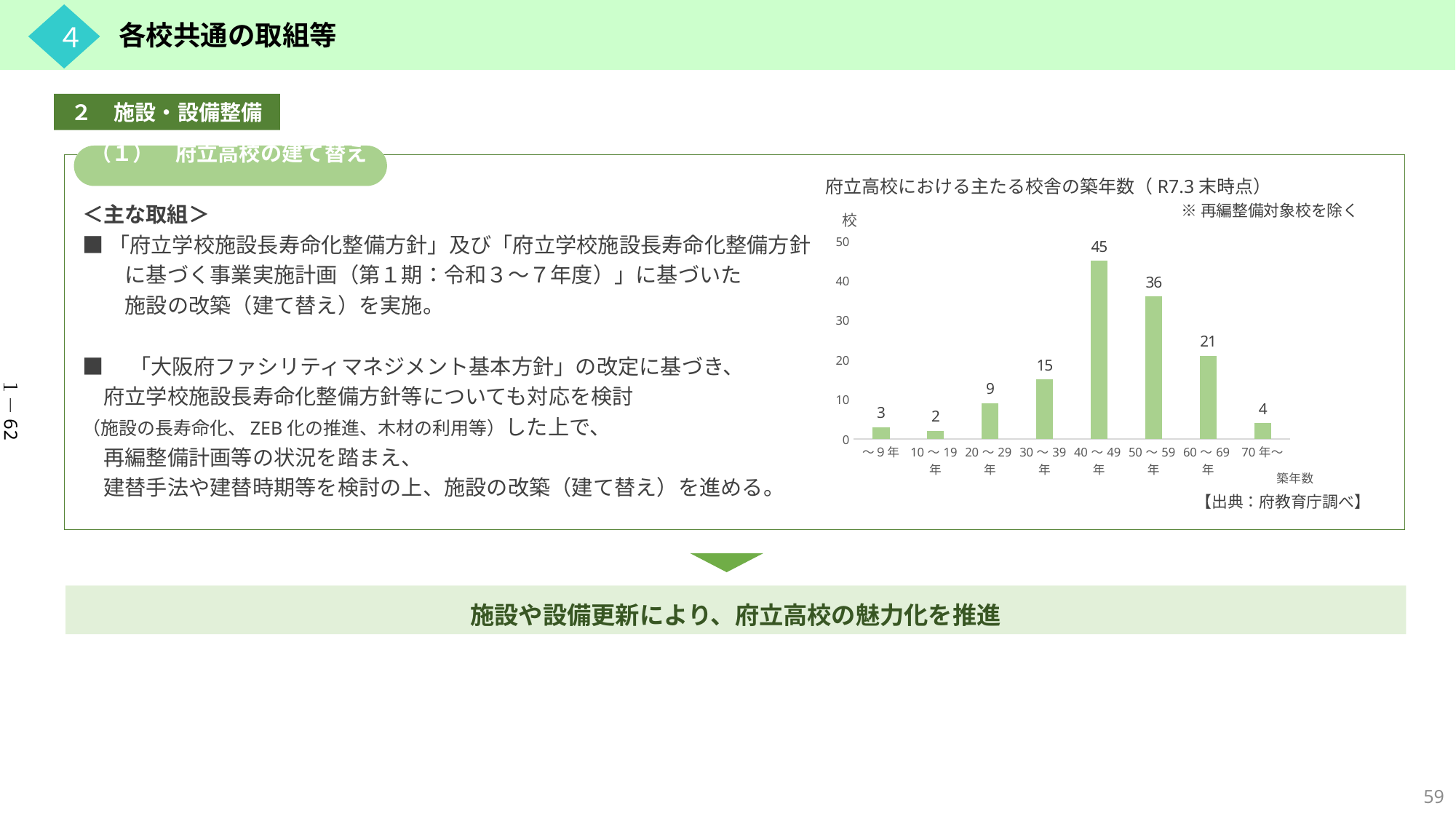
Is the value for 50～59年 greater or less than 30? greater Which category has the lowest value? 10～19年 What is the value for the 10～19年 category? 2 What is the title of the chart? 府立高校における主たる校舎の築年数（R7.3末時点） Which is larger, the value for 30～39年 or the value for 60～69年? 60～69年 What kind of chart is shown on the slide? bar chart What is the value for the 40～49年 category? 45 How many categories are shown on the x axis? 8 Do the values rise or fall from 10～19年 to 40～49年? rise What is the value for the 70年～ category? 4 Which category has the highest value? 40～49年 What is the difference between the values for 40～49年 and 50～59年? 9